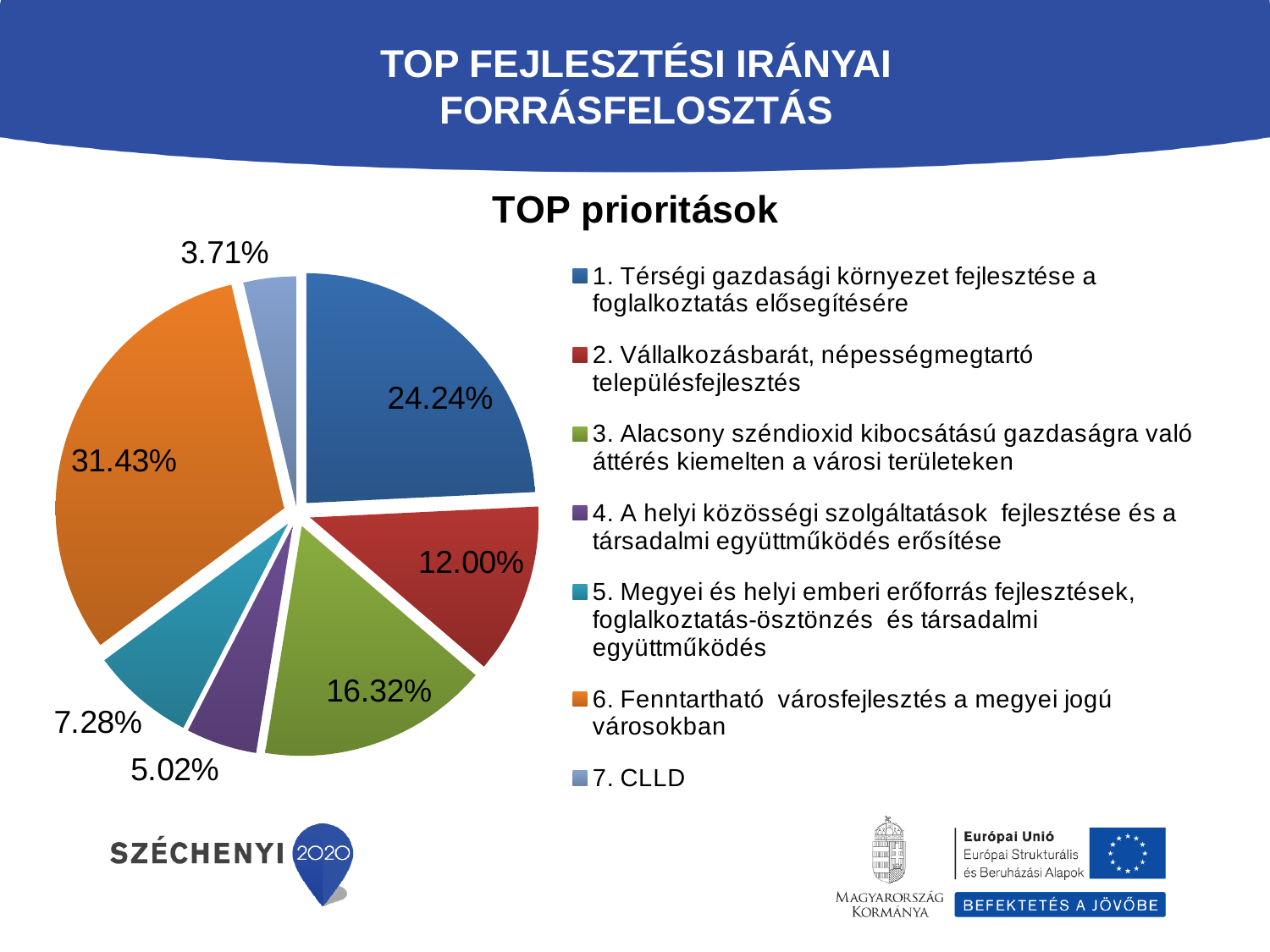
What colour is the slice for "2. Vállalkozásbarát, népességmegtartó településfejlesztés"? red What is the value shown for "7. CLLD"? 3.71% What is the value shown for "3. Alacsony széndioxid kibocsátású gazdaságra való áttérés kiemelten a városi területeken"? 16.32% What share of the pie does "1. Térségi gazdasági környezet fejlesztése a foglalkoztatás elősegítésére" have? 24.24% What share of the pie does "6. Fenntartható városfejlesztés a megyei jogú városokban" have? 31.43% Which category has the smallest slice of the pie? 7. CLLD Which is larger: the share for "5. Megyei és helyi emberi erőforrás fejlesztések, foglalkoztatás-ösztönzés és társadalmi együttműködés" or the share for "4. A helyi közösségi szolgáltatások fejlesztése és a társadalmi együttműködés erősítése"? 5. Megyei és helyi emberi erőforrás fejlesztések, foglalkoztatás-ösztönzés és társadalmi együttműködés How many slices does the pie chart have? 7 What kind of chart is shown on the slide? pie chart What is the title of the chart? TOP prioritások Which category has the largest slice of the pie? 6. Fenntartható városfejlesztés a megyei jogú városokban What is the difference between the shares of "2. Vállalkozásbarát, népességmegtartó településfejlesztés" and "4. A helyi közösségi szolgáltatások fejlesztése és a társadalmi együttműködés erősítése"? 6.98%